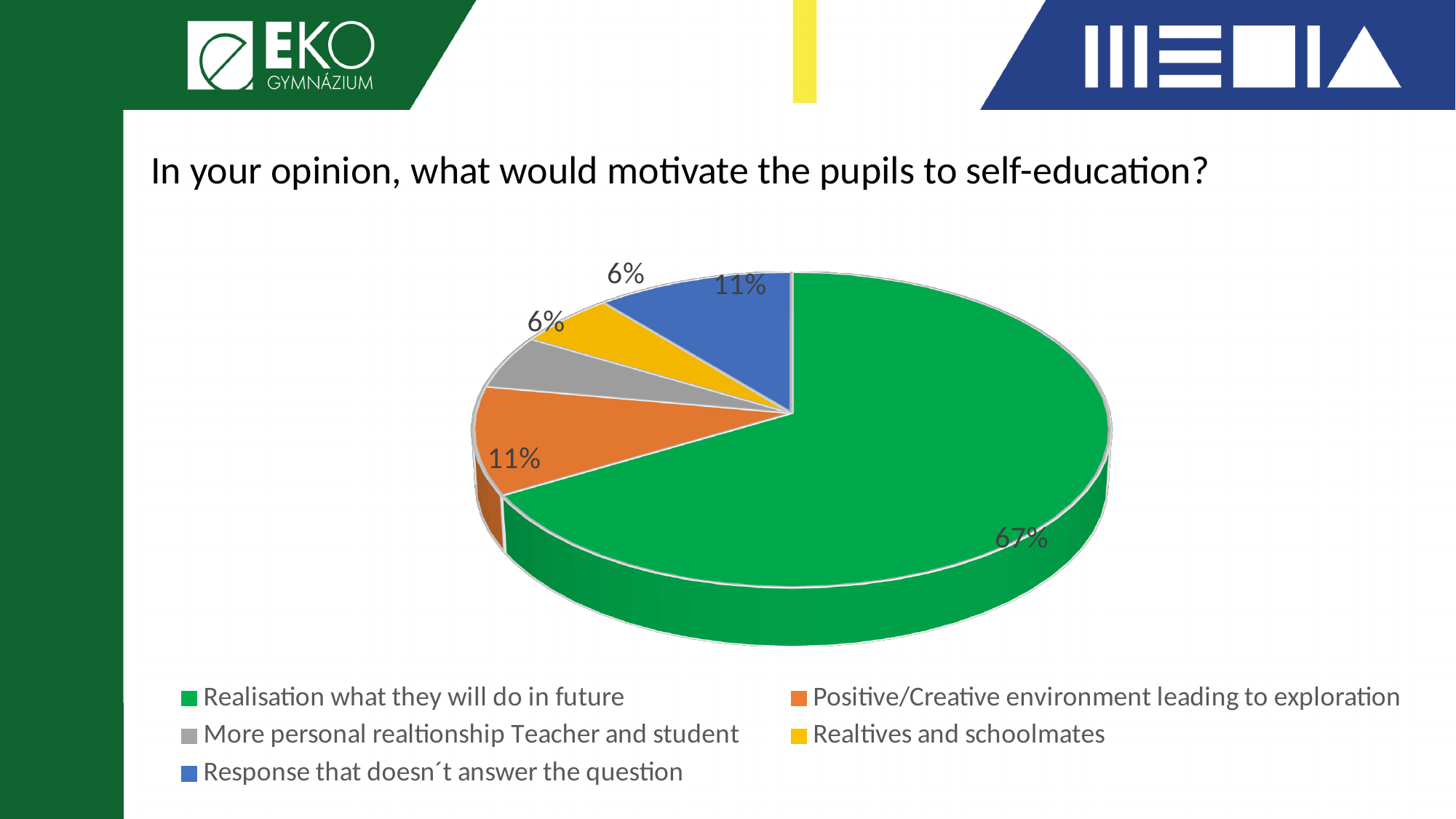
Which category has the largest share of the pie? Realisation what they will do in future What kind of chart is shown on the slide? pie chart Which is larger: the share for "Response that doesn´t answer the question" or the share for "Realtives and schoolmates"? Response that doesn´t answer the question What is the value for "Realtives and schoolmates"? 6% What share of the pie does "Realisation what they will do in future" have? 67% What colour is the slice for "Realtives and schoolmates"? yellow What is the value for "Positive/Creative environment leading to exploration"? 11% What is the difference between the share for "Realisation what they will do in future" and the share for "Positive/Creative environment leading to exploration"? 56% How many entries does the legend list? 5 How many slices does the pie chart have? 5 What is the value for "Response that doesn´t answer the question"? 11% What is the value for "More personal realtionship Teacher and student"? 6%